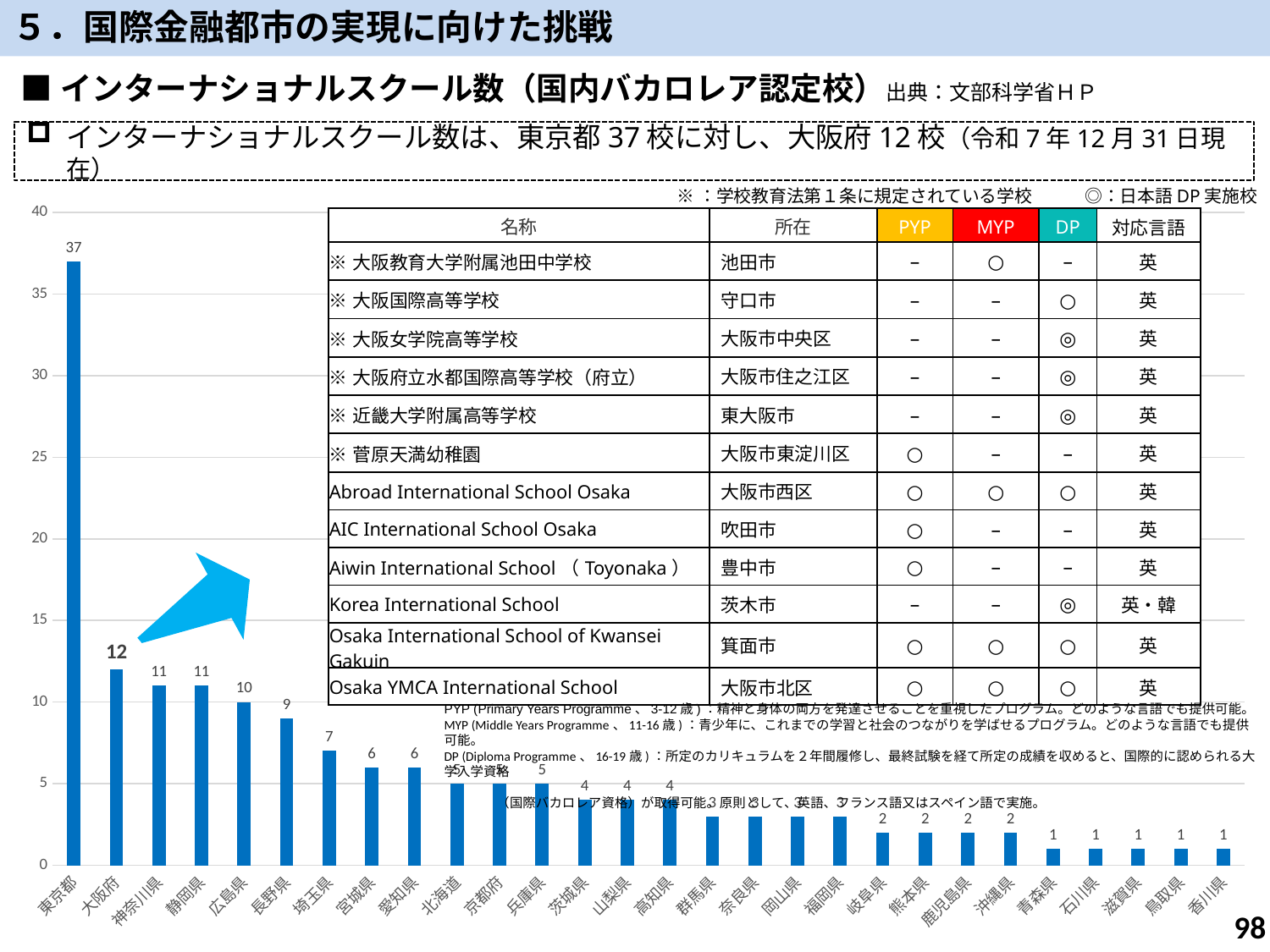
Do the values rise or fall moving from left to right along the x axis? fall What is the value for 埼玉県 in the bar chart? 7 What is the value for 大阪府 in the bar chart? 12 What is the value for 東京都 in the bar chart? 37 What is the difference between the values for 東京都 and 大阪府? 25 Which prefecture has the highest value in the bar chart? 東京都 What kind of chart is used to show the number of international schools by prefecture? bar chart Is the value for 東京都 greater or less than 35? greater What is the value for 広島県 in the bar chart? 10 What is the value for 神奈川県 in the bar chart? 11 Which has a larger value, 広島県 or 長野県? 広島県 How many prefectures are shown on the x axis of the bar chart? 28